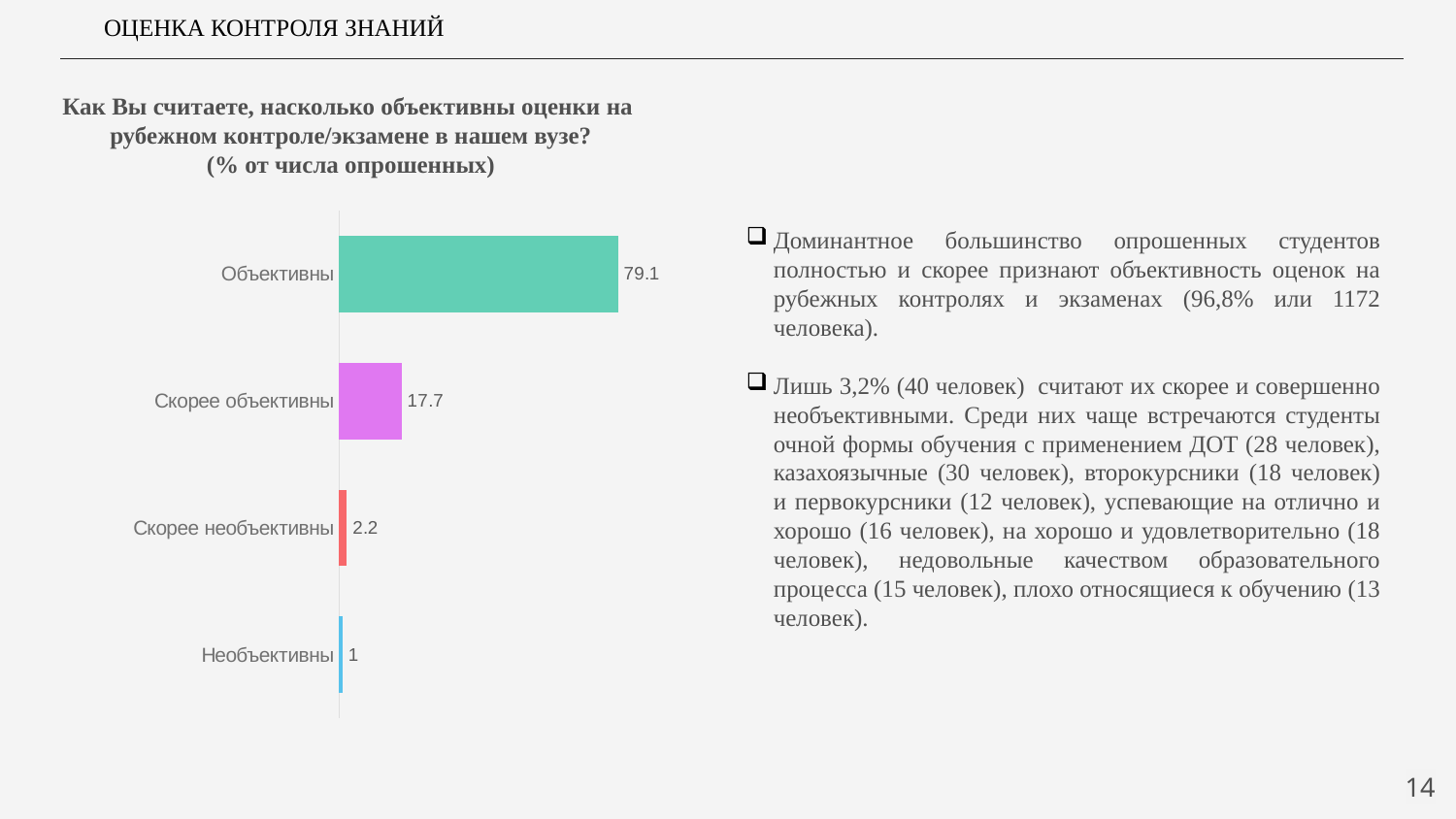
What is the value for Объективны? 79.1 How many categories are shown in the chart? 4 What is the value for Необъективны? 1 Which category has the lowest value? Необъективны Which category has the highest value? Объективны What is the value for Скорее необъективны? 2.2 Which is larger, the value for Скорее объективны or the value for Скорее необъективны? Скорее объективны What is the title of the chart? Как Вы считаете, насколько объективны оценки на рубежном контроле/экзамене в нашем вузе? (% от числа опрошенных) What is the difference between the values for Скорее необъективны and Необъективны? 1.2 What kind of chart is shown on the slide? Bar chart What is the value for Скорее объективны? 17.7 What is the difference between the values for Объективны and Скорее объективны? 61.4